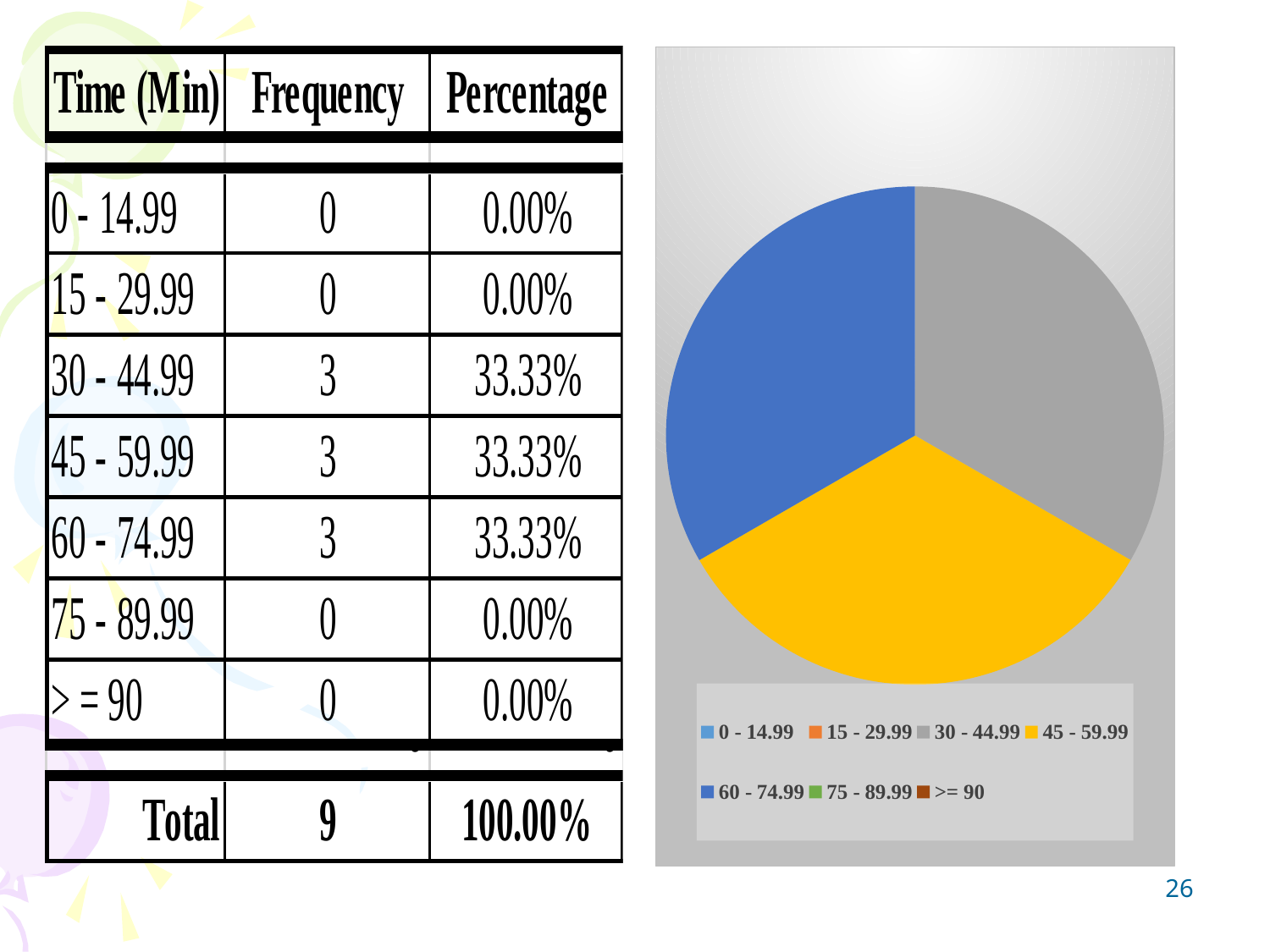
Is the share of the 45 - 59.99 slice in the pie chart greater or less than 50%? less What percentage does the table give for the 0 - 14.99 category? 0.00% According to the table, what share of the pie does the 45 - 59.99 category represent? 33.33% What kind of chart is shown on the right of the slide? pie chart What colour is the 60 - 74.99 slice in the pie chart? blue What frequency does the table give for the 60 - 74.99 category? 3 According to the table, what share of the pie does the 30 - 44.99 category represent? 33.33% According to the table, what share of the pie does the 60 - 74.99 category represent? 33.33% What colour is the 30 - 44.99 slice in the pie chart? grey How many slices are visible in the pie chart? 3 What is the total frequency shown in the table that the pie chart is based on? 9 How many categories does the pie chart's legend list? 7